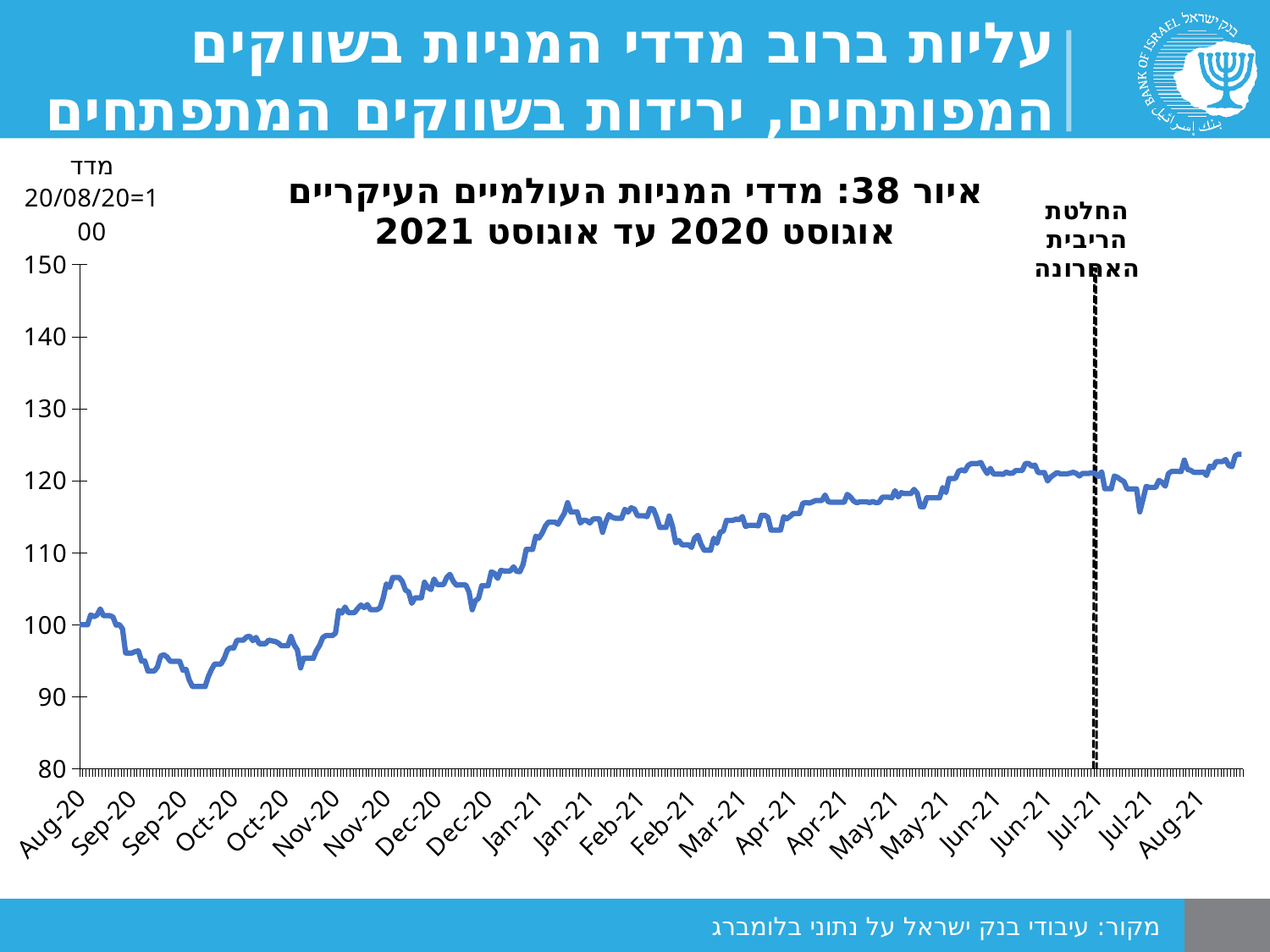
Which is higher: the index value in Aug-20 or in Aug-21? Aug-21 Is the value of the index at the end of the series (Aug-21) greater or less than 120? greater Overall, does the index rise or fall from Aug-20 to Aug-21? rise How many lines (series) are plotted on the chart? 1 Is the value of the index in Apr-21 greater or less than 110? greater What kind of chart is shown on the slide? line chart What event does the dashed vertical line near Jul-21 mark, according to its label? החלטת הריבית האחרונה Is the lowest value of the index in Oct-20 greater or less than 100? less Which is higher: the index value in Oct-20 or in Dec-20? Dec-20 In which month does the index reach its lowest point? Sep-20